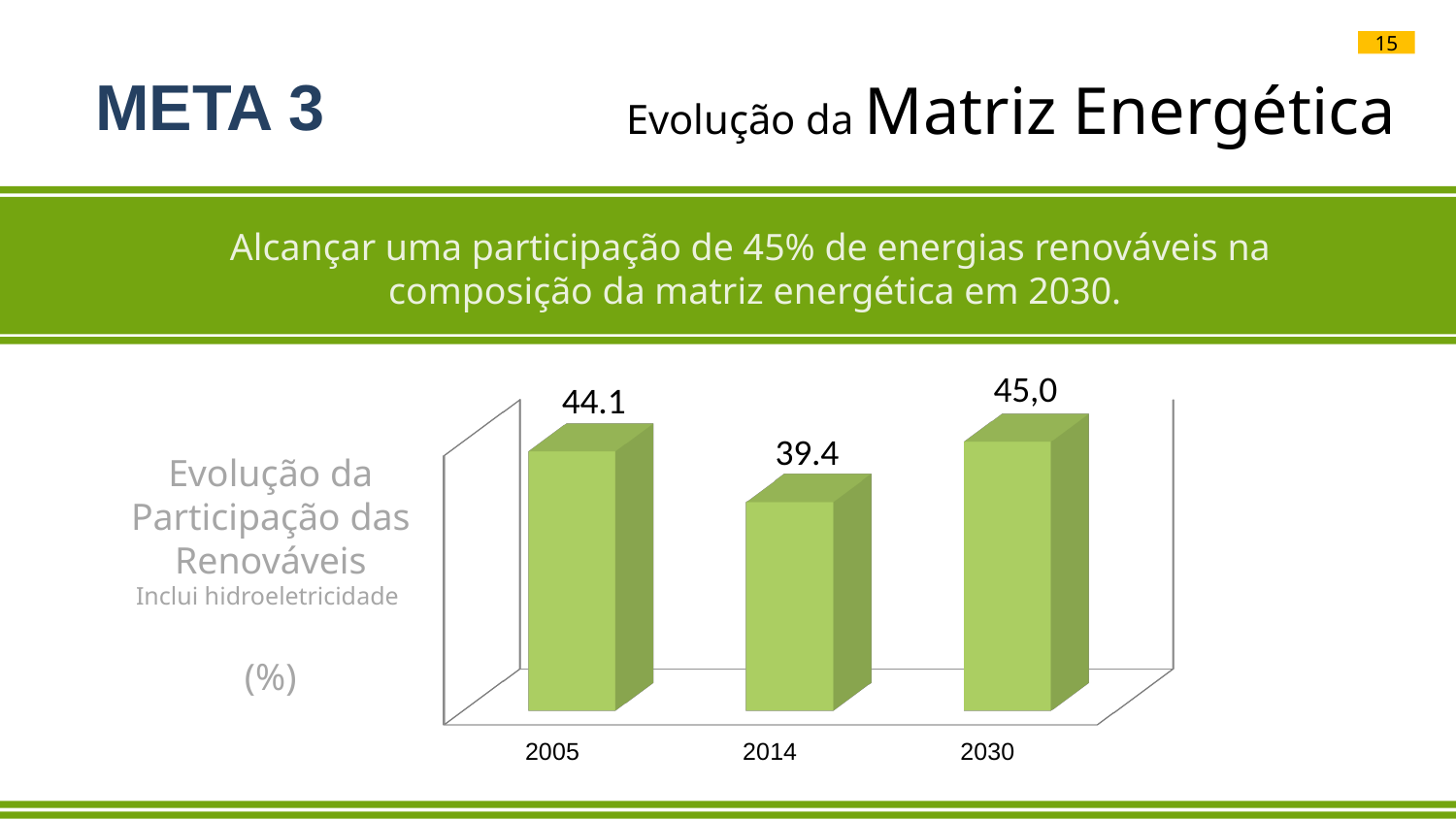
Which year has the lowest value? 2014 Does the value rise or fall from 2005 to 2014? Fall What is the title of the chart? Evolução da Participação das Renováveis What is the value for 2005? 44.1 What is the difference between the values for 2030 and 2014? 5.6 What is the value shown for 2030? 45,0 Which is larger, the value for 2005 or the value for 2014? 2005 Which year has the highest value? 2030 What is the difference between the values for 2005 and 2014? 4.7 How many bars are shown in the chart? 3 What is the value for 2014? 39.4 What kind of chart is shown on the slide? Bar chart